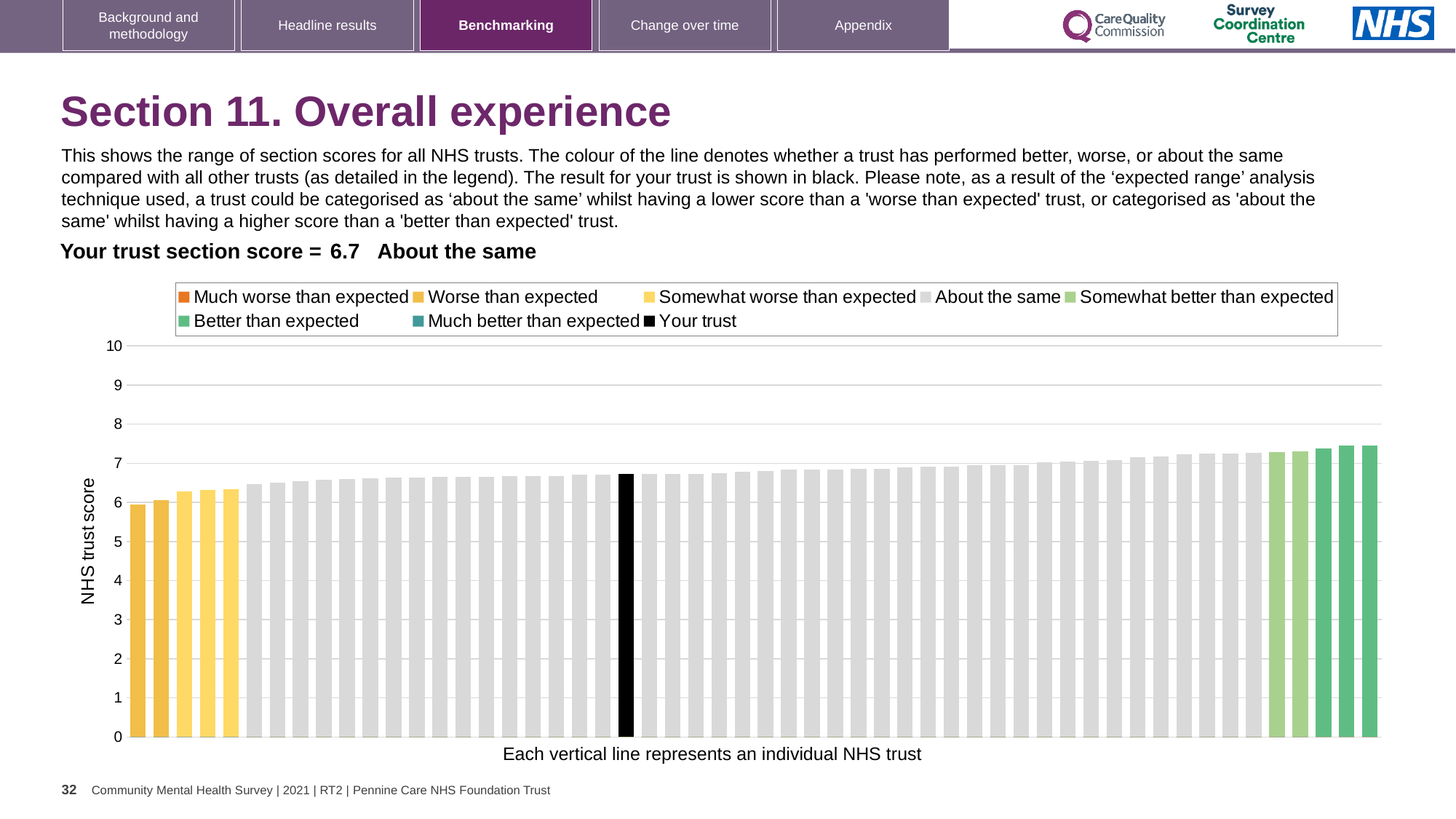
Is the value of the black 'Your trust' bar greater or less than 5? greater Which benchmarking category is your trust placed in for Section 11? About the same What is the section score for your trust shown on the slide? 6.7 What kind of chart is shown on the slide? Bar chart Is the value of the lowest bar in the chart greater or less than 7? less How many entries does the chart legend list? 8 Do the bar values rise or fall from left to right along the x axis? Rise What colour is used for the 'Your trust' bar in the chart? Black Is the value of the highest bar in the chart greater or less than 8? less What is the label of the vertical axis of the chart? NHS trust score What is the maximum value shown on the vertical axis of the chart? 10